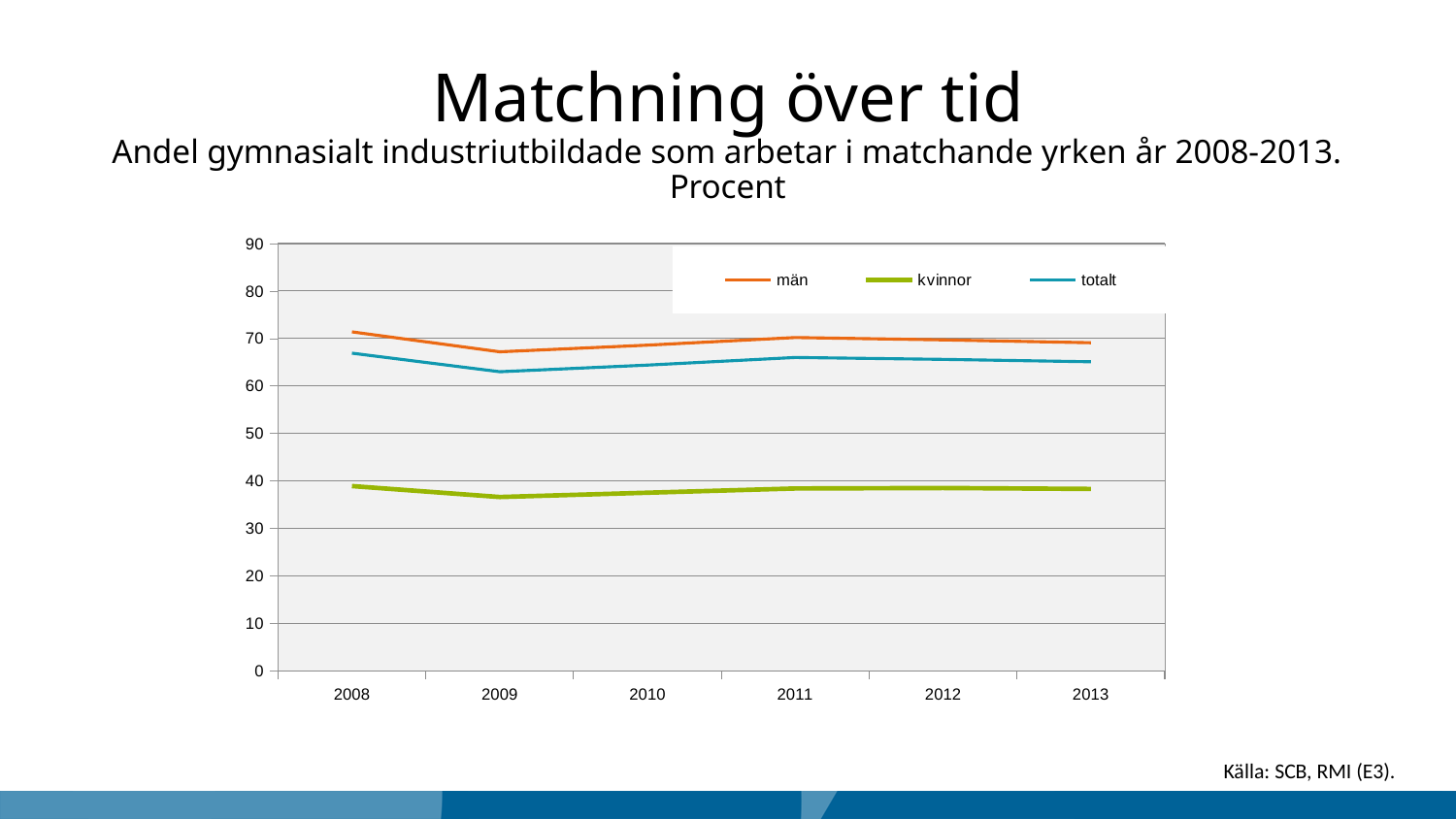
Is the value for kvinnor in 2013 greater or less than 40? less How many years are shown on the x axis? 6 Does the value for totalt rise or fall from 2008 to 2009? fall Which is larger in 2011, the value for män or the value for kvinnor? män Which series has the highest values across all years? män Is the value for män in 2008 greater or less than 70? greater Which series has the lowest values across all years? kvinnor Is the value for totalt in 2009 greater or less than 60? greater How many series does the legend list? 3 What kind of chart is shown on the slide? line chart In which year is the value for män lowest? 2009